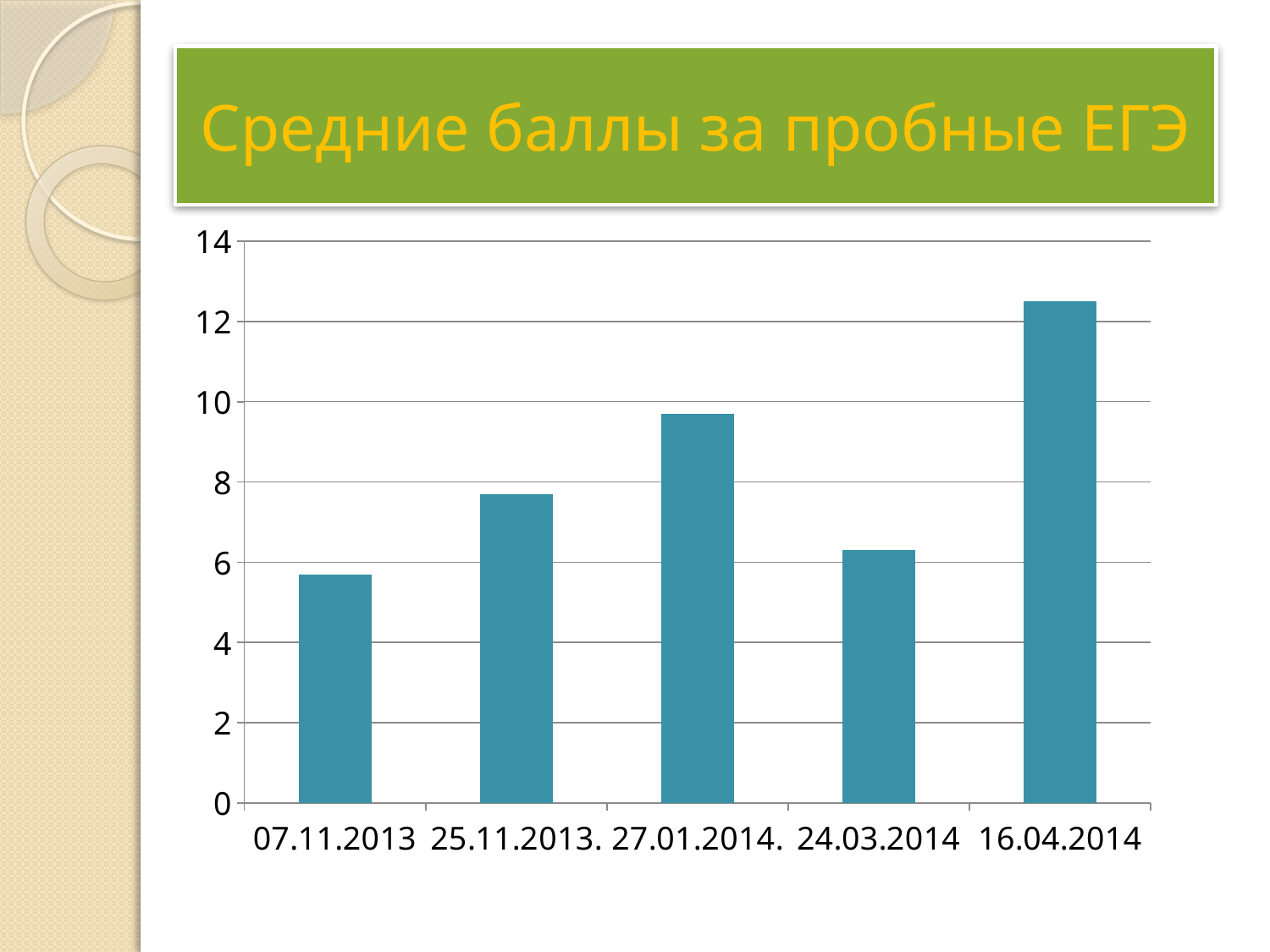
Does the value rise or fall from 27.01.2014 to 24.03.2014? fall Which date has the highest bar? 16.04.2014 Which date has the lowest bar? 07.11.2013 Which is larger, the value for 25.11.2013 or the value for 24.03.2014? 25.11.2013 Is the value for 16.04.2014 greater or less than 12? greater Is the value for 24.03.2014 greater or less than 6? greater Is the value for 27.01.2014 greater or less than 10? less What is the title of the chart? Средние баллы за пробные ЕГЭ What kind of chart is shown on the slide? bar chart How many dates (categories) are shown on the x axis? 5